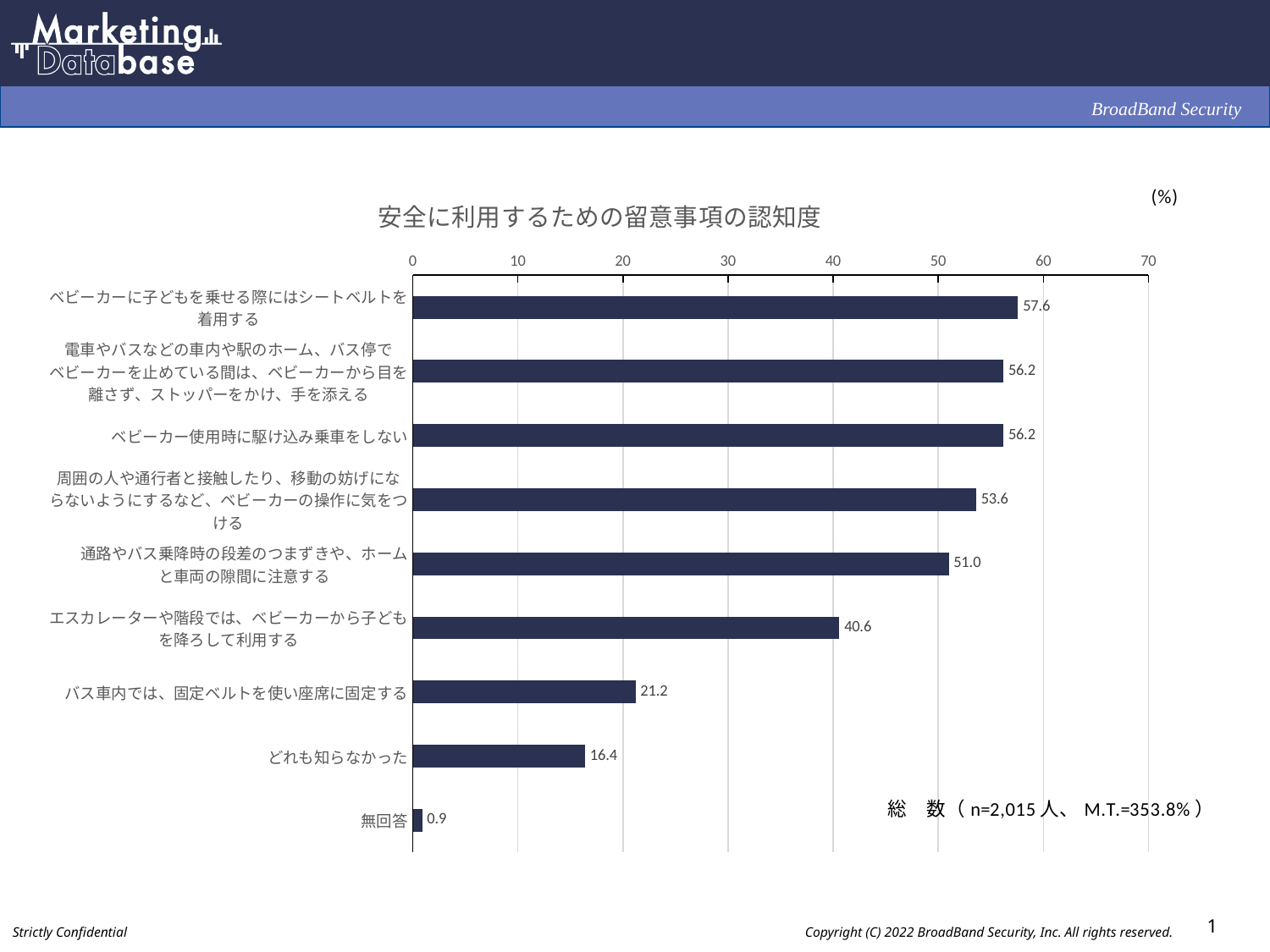
Which category has the lowest value? 無回答 What is the sample size (n) shown on the slide? n=2,015人 What is the title of the chart? 安全に利用するための留意事項の認知度 Is the value for 「周囲の人や通行者と接触したり、移動の妨げにならないようにするなど、ベビーカーの操作に気をつける」 greater or less than 50? greater What is the value for 「エスカレーターや階段では、ベビーカーから子どもを降ろして利用する」? 40.6 Which category has the highest value? ベビーカーに子どもを乗せる際にはシートベルトを着用する How many categories are plotted in the chart? 9 What is the value for 「ベビーカーに子どもを乗せる際にはシートベルトを着用する」? 57.6 What type of chart is shown on the slide? bar chart Which is larger: the value for 「通路やバス乗降時の段差のつまずきや、ホームと車両の隙間に注意する」 or the value for 「エスカレーターや階段では、ベビーカーから子どもを降ろして利用する」? 通路やバス乗降時の段差のつまずきや、ホームと車両の隙間に注意する What is the difference between the values for 「ベビーカー使用時に駆け込み乗車をしない」 and 「バス車内では、固定ベルトを使い座席に固定する」? 35.0 What is the value for 「どれも知らなかった」? 16.4